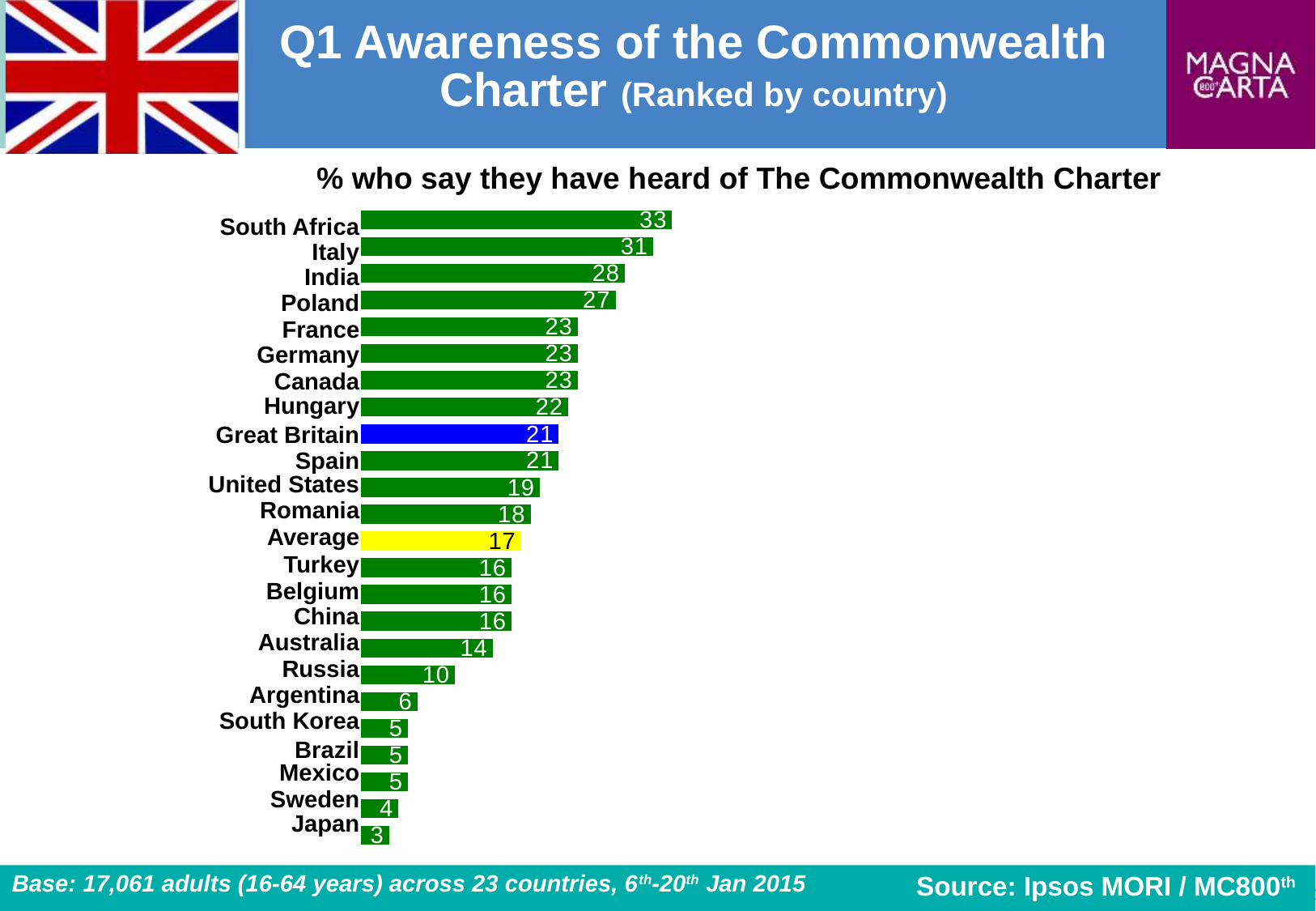
What kind of chart is shown on the slide? Bar chart Which has a higher value, Poland or Hungary? Poland How many bars are shown on the chart, including the Average bar? 24 What percentage of people in South Africa say they have heard of The Commonwealth Charter? 33 What is the difference between the values for South Africa and Italy? 2 What is the Average value shown on the chart? 17 What is the difference between the values for India and Russia? 18 What is the value shown for Japan? 3 Which country has the lowest percentage who say they have heard of The Commonwealth Charter? Japan What colour is the bar for Great Britain? Blue What is the value shown for Great Britain? 21 Which country has the highest percentage who say they have heard of The Commonwealth Charter? South Africa